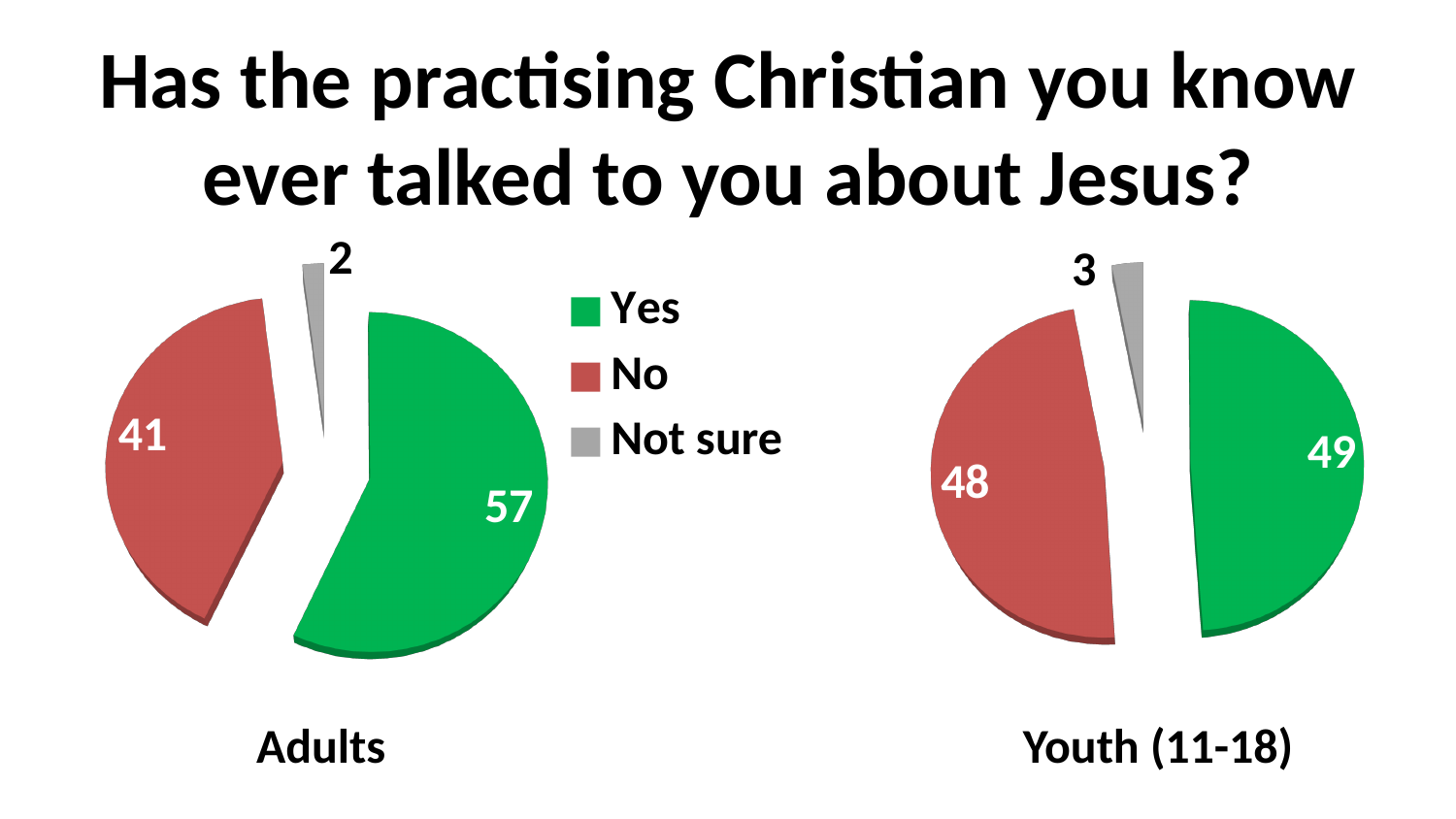
How many entries does the legend list? 3 In the Youth (11-18) pie chart, what is the value for No? 48 How many categories does each pie chart show? 3 In the Adults pie chart, what is the value for No? 41 In the Adults pie chart, which category has the largest slice? Yes Which is larger in the Adults pie chart: the value for Yes or the value for No? Yes In the Youth (11-18) pie chart, what is the value for Not sure? 3 Which colour represents Not sure in the legend? Grey In the Youth (11-18) pie chart, which category has the smallest slice? Not sure In the Adults pie chart, what is the value for Yes? 57 In the Adults pie chart, what is the difference between the Yes and No values? 16 What kind of chart is used for the Adults data? Pie chart